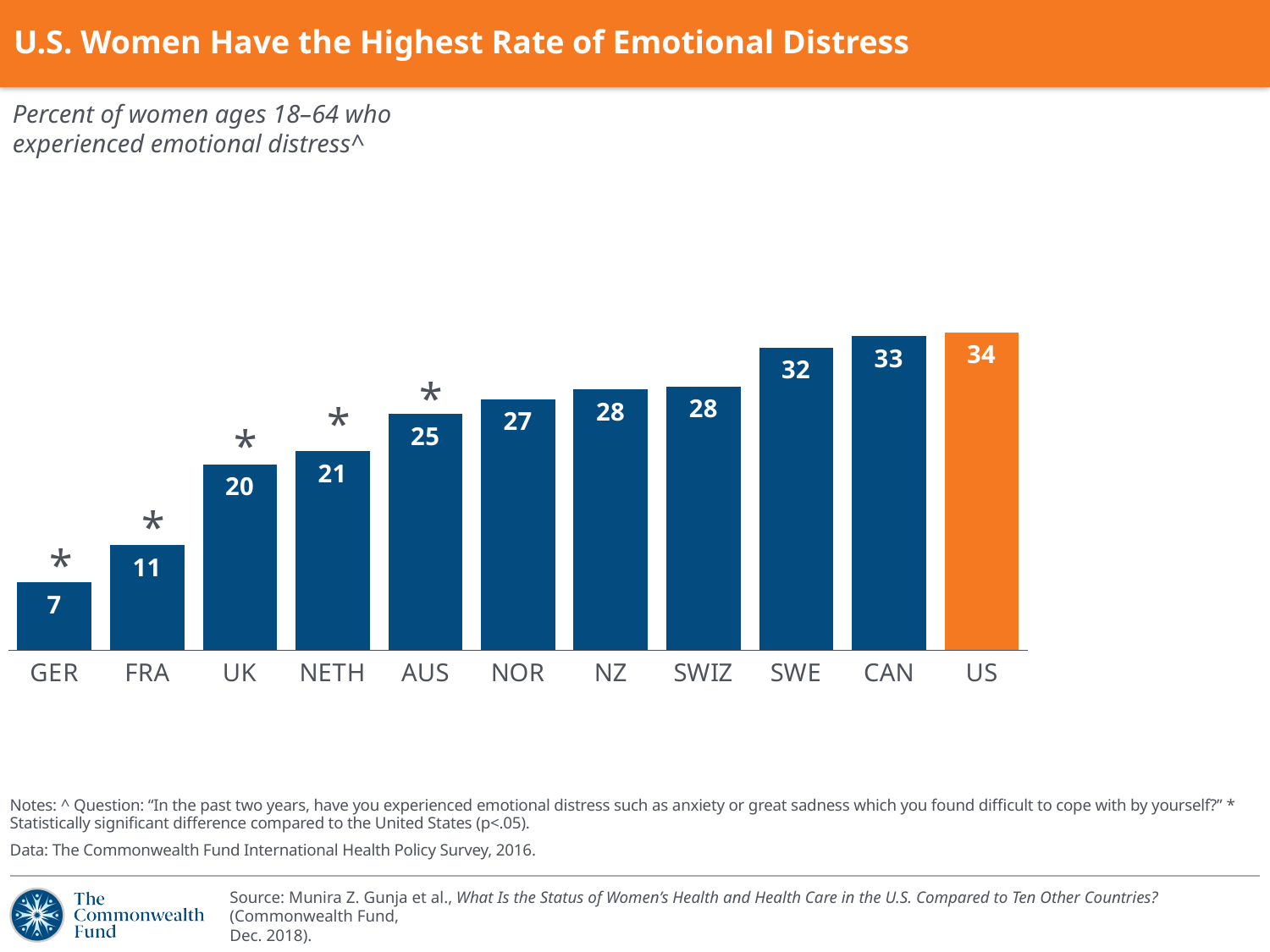
What is the difference between the values for US and GER? 27 Which is larger, the value for SWE or the value for AUS? SWE What kind of chart is this? bar chart What is the difference between the values for CAN and UK? 13 How many countries are shown on the chart? 11 Which country has the highest value? US Which country has the lowest value? GER What is the value for GER? 7 What is the value for the US? 34 Which bar is coloured orange rather than blue? US What is the value for NETH? 21 Do the values rise or fall from left to right along the x axis? rise